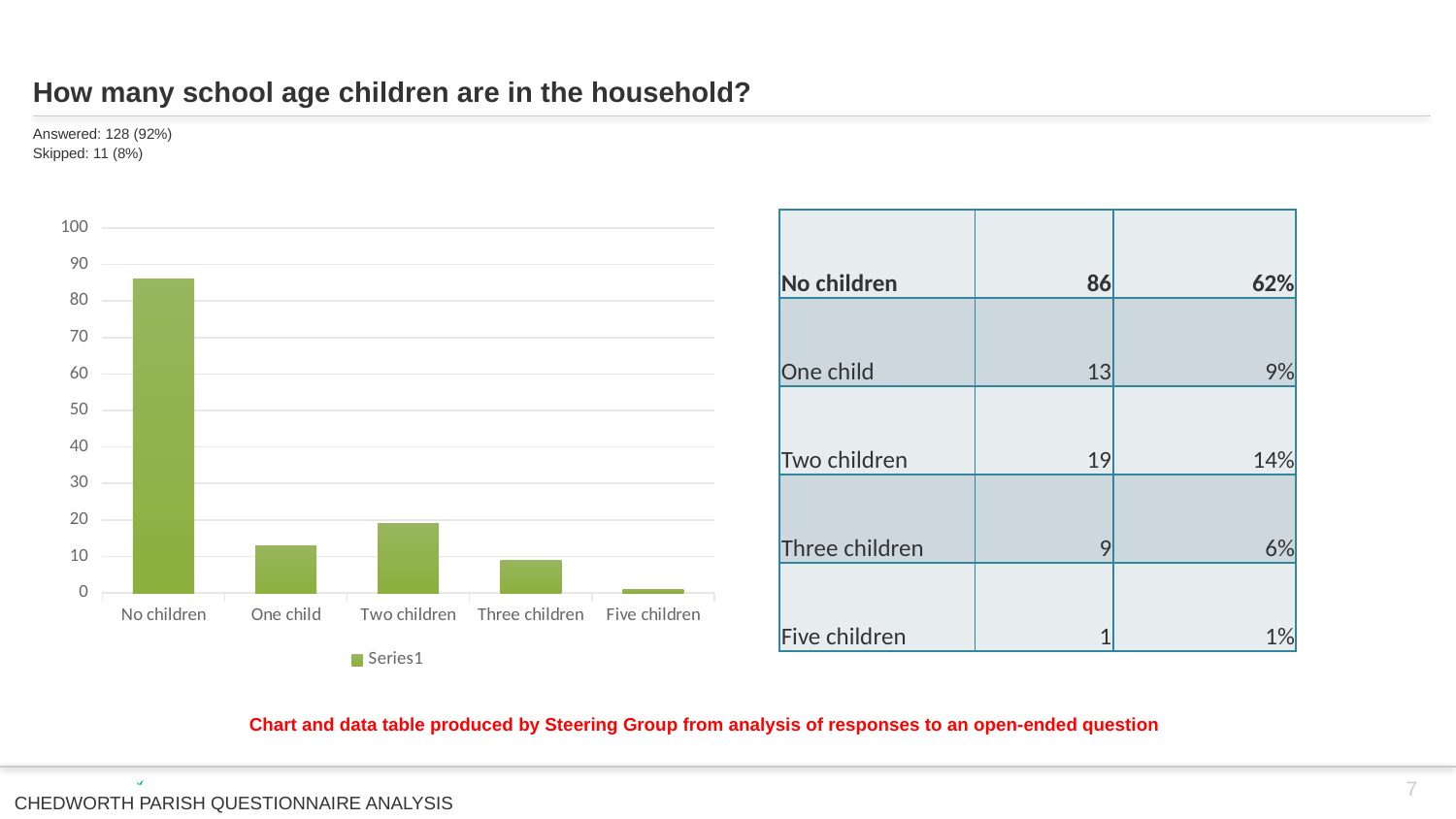
Is the bar for One child greater or less than 20? less How many categories are shown on the x axis of the bar chart? 5 According to the data table, what percentage of households have Two children? 14% Using the data table, what is the difference between the counts for No children and Two children? 67 How many series does the chart legend list? 1 What kind of chart is shown on the slide? bar chart Which is larger, the value for Two children or the value for One child? Two children Which category has the lowest bar in the chart? Five children According to the data table, what is the count for No children? 86 According to the data table, what is the count for Three children? 9 Which category has the highest bar in the chart? No children Is the bar for No children greater or less than 80? greater